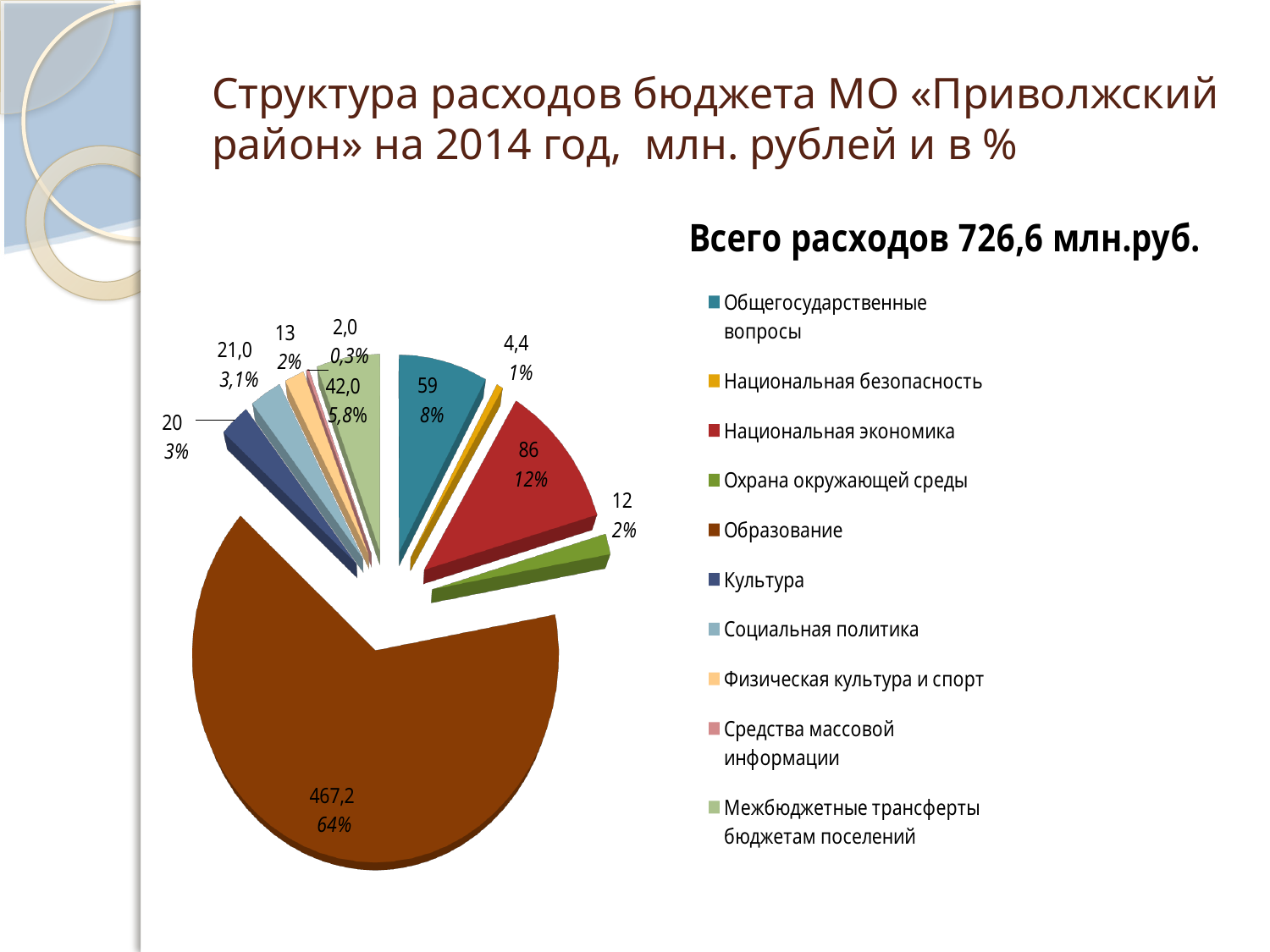
What is the value shown for Образование in the pie chart? 467,2 What share of the pie does Образование account for? 64% What type of chart is shown on the slide? pie chart Which category has the largest slice of the pie? Образование What percentage is shown for Общегосударственные вопросы? 8% Which is larger: the value for Национальная экономика or the value for Общегосударственные вопросы? Национальная экономика Which category has the smallest slice of the pie? Средства массовой информации How many categories does the legend of the pie chart list? 10 What is the difference between the values for Социальная политика (21,0) and Культура (20)? 1,0 What total expenditure is stated above the legend? 726,6 млн.руб. What is the value shown for Национальная экономика? 86 What is the value shown for Межбюджетные трансферты бюджетам поселений? 42,0